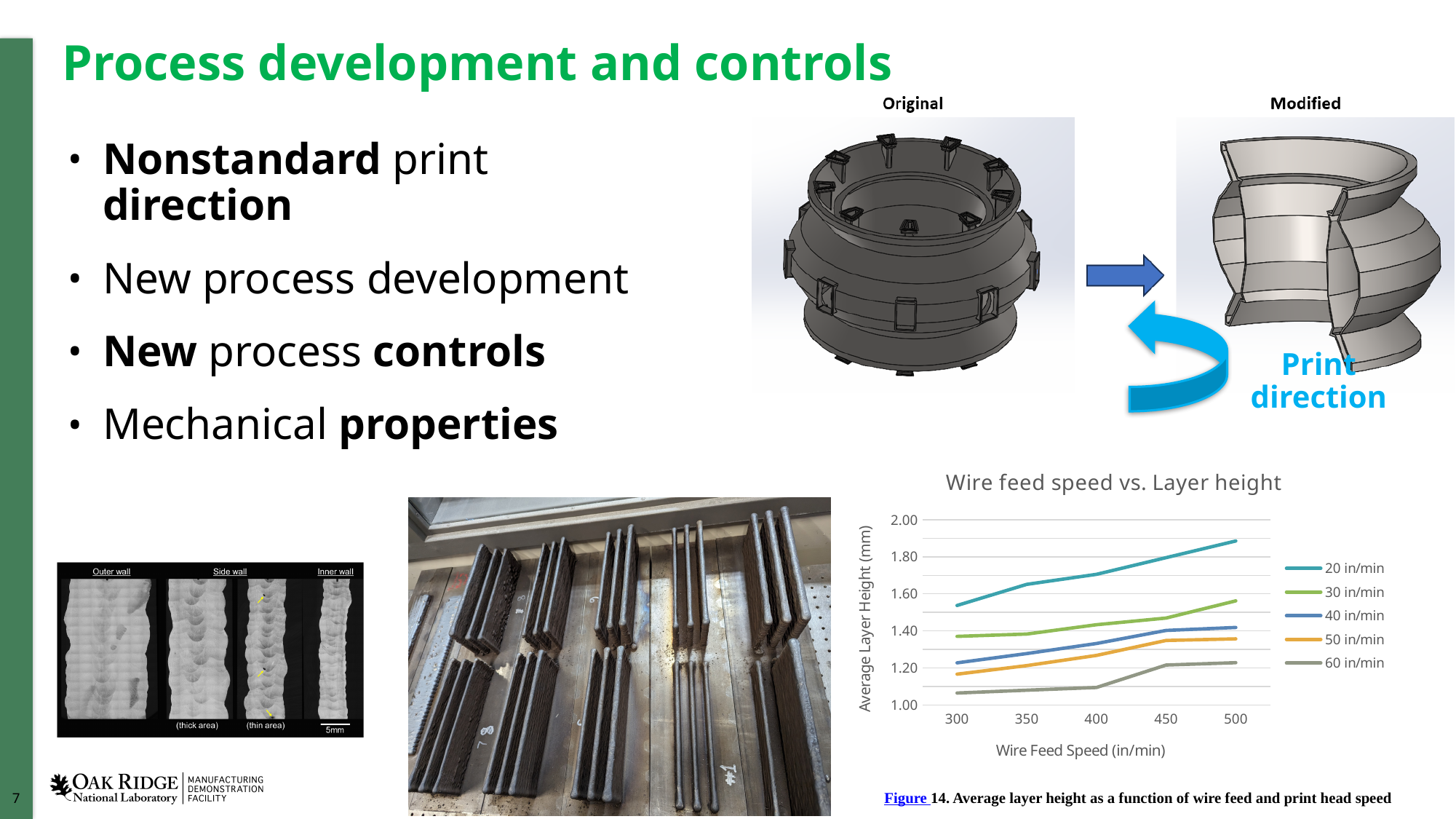
In the 'Wire feed speed vs. Layer height' chart, which series has the lowest average layer height across the plotted range? 60 in/min In the 'Wire feed speed vs. Layer height' chart, at 500 in/min wire feed speed, which is larger: the 30 in/min series or the 40 in/min series? 30 in/min How many series does the legend of the 'Wire feed speed vs. Layer height' chart list? 5 In the 'Wire feed speed vs. Layer height' chart, is the value for the 20 in/min series at 500 in/min wire feed speed greater or less than 1.80? greater In the 'Wire feed speed vs. Layer height' chart, is the value for the 20 in/min series at 300 in/min wire feed speed greater or less than 1.60? less What is the y-axis label of the 'Wire feed speed vs. Layer height' chart? Average Layer Height (mm) In the 'Wire feed speed vs. Layer height' chart, does the 20 in/min series rise or fall as wire feed speed increases from 300 to 500? rise What kind of chart is 'Wire feed speed vs. Layer height'? line chart In the 'Wire feed speed vs. Layer height' chart, which series has the highest average layer height at 500 in/min wire feed speed? 20 in/min What is the title of the line chart on the slide? Wire feed speed vs. Layer height In the 'Wire feed speed vs. Layer height' chart, is the value for the 60 in/min series at 300 in/min wire feed speed greater or less than 1.20? less How many wire feed speed values are marked on the x axis of the 'Wire feed speed vs. Layer height' chart? 5